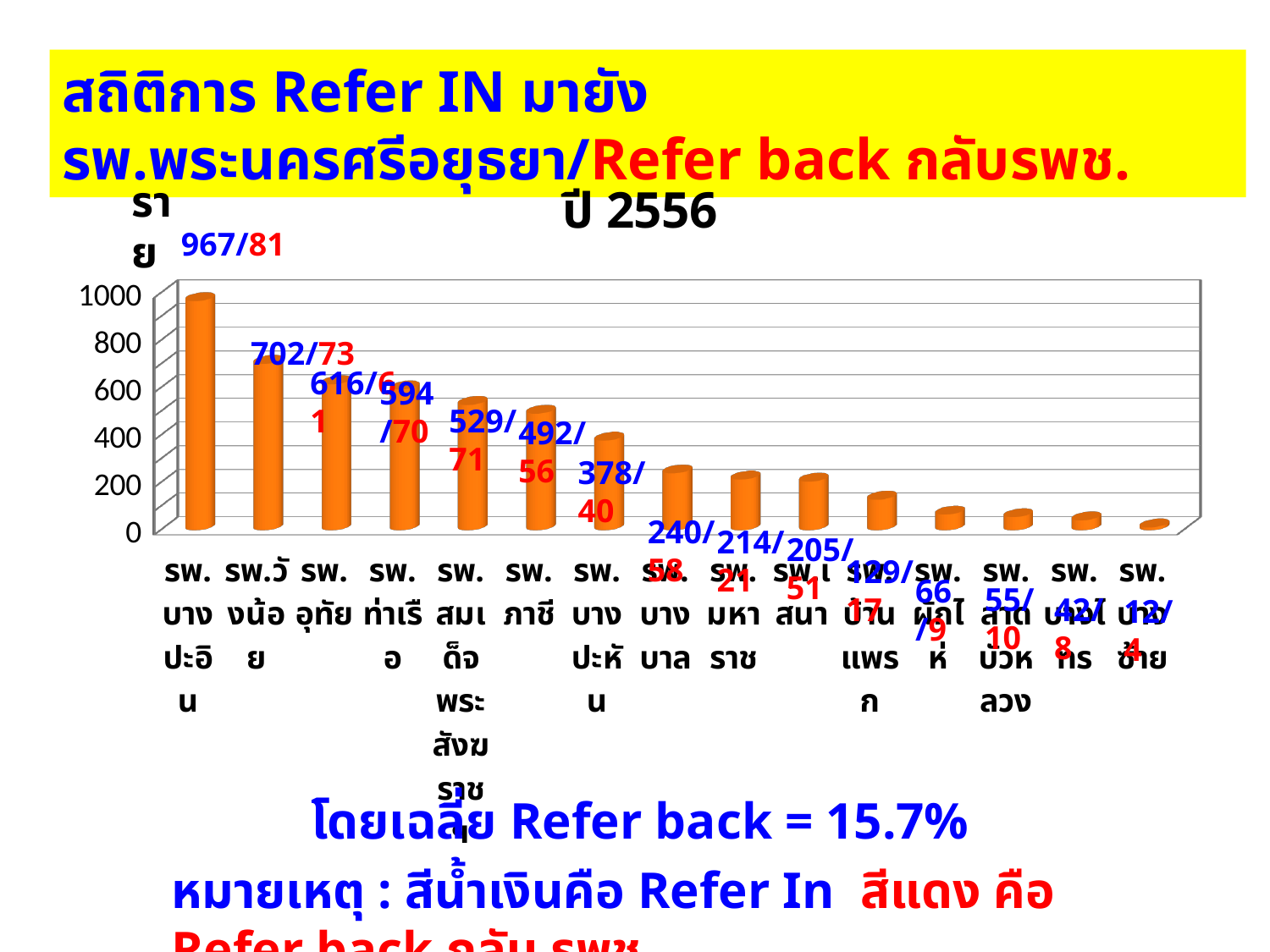
Which hospital has the highest Refer In value in the chart? รพ.บางปะอิน What is the Refer back value (red) for รพ.ภาชี? 56 What kind of chart is shown on the slide? bar chart What is the Refer In value (blue) for รพ.วังน้อย? 702 Do the bar values rise or fall from left to right along the x axis? fall How many hospitals (bars) are shown in the chart? 15 What is the difference between the Refer In values of รพ.บางปะอิน and รพ.วังน้อย? 265 What is the Refer In value (blue) for รพ.บางปะอิน? 967 Which has a larger Refer In value, รพ.ท่าเรือ or รพ.ภาชี? รพ.ท่าเรือ What is the Refer In value (blue) for รพ.บางปะหัน? 378 What is the Refer back value (red) for รพ.บางปะอิน? 81 According to the note on the slide, what does the blue colour represent? Refer In